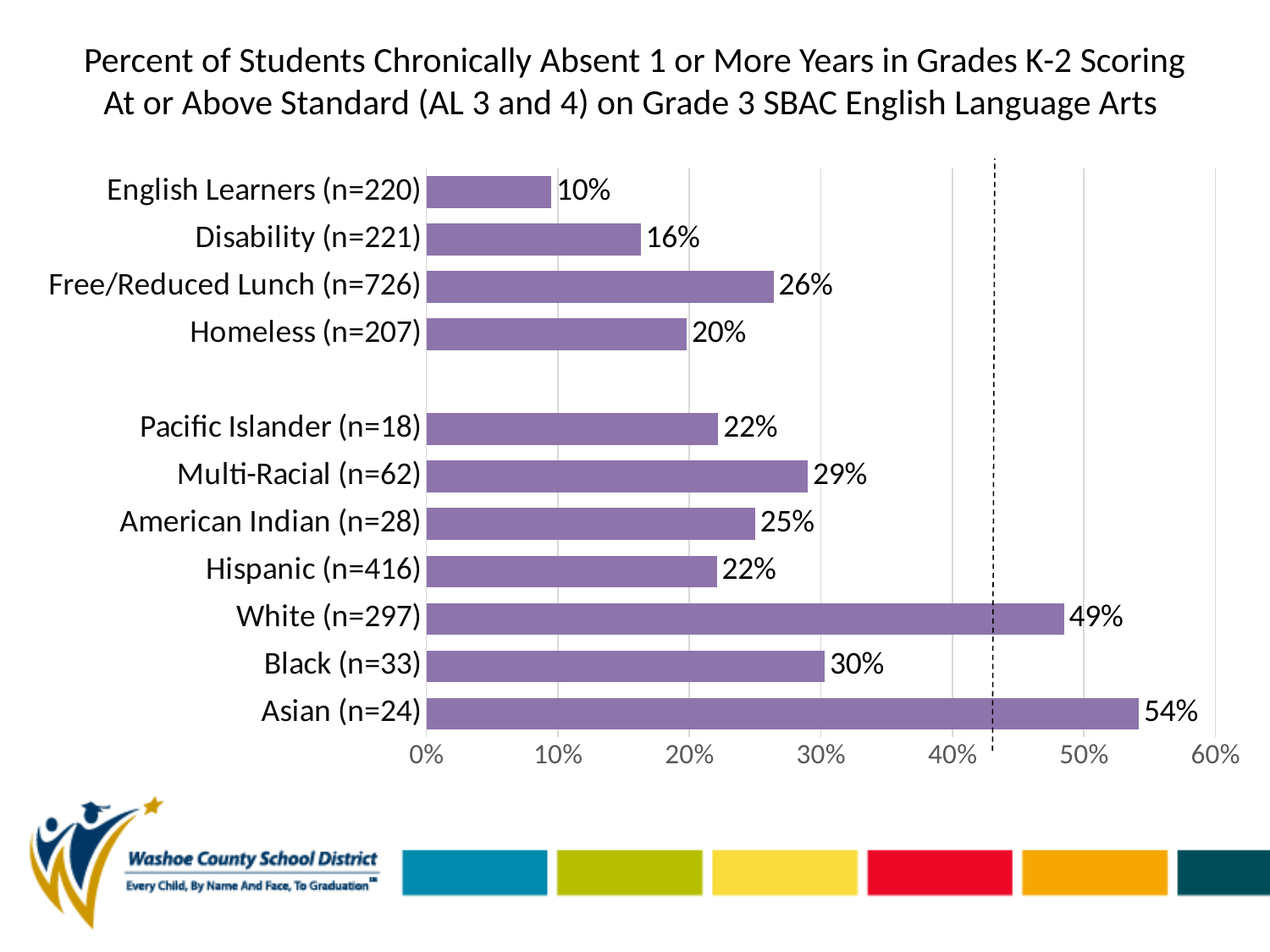
Which category has the lowest value on the chart? English Learners (n=220) What is the highest value labelled on the horizontal axis? 60% Is the value for White (n=297) greater or less than 40%? greater How many categories (bars) are plotted on the chart? 11 What kind of chart is shown on the slide? Bar chart Which is larger, the value for Black (n=33) or the value for Multi-Racial (n=62)? Black (n=33) What is the value shown for English Learners (n=220)? 10% What is the difference between the values for Disability (n=221) and Homeless (n=207)? 4% What is the difference between the values for White (n=297) and Hispanic (n=416)? 27% Which category has the highest value on the chart? Asian (n=24) What percent of students in the Asian (n=24) group scored at or above standard? 54% What is the value shown for Free/Reduced Lunch (n=726)? 26%